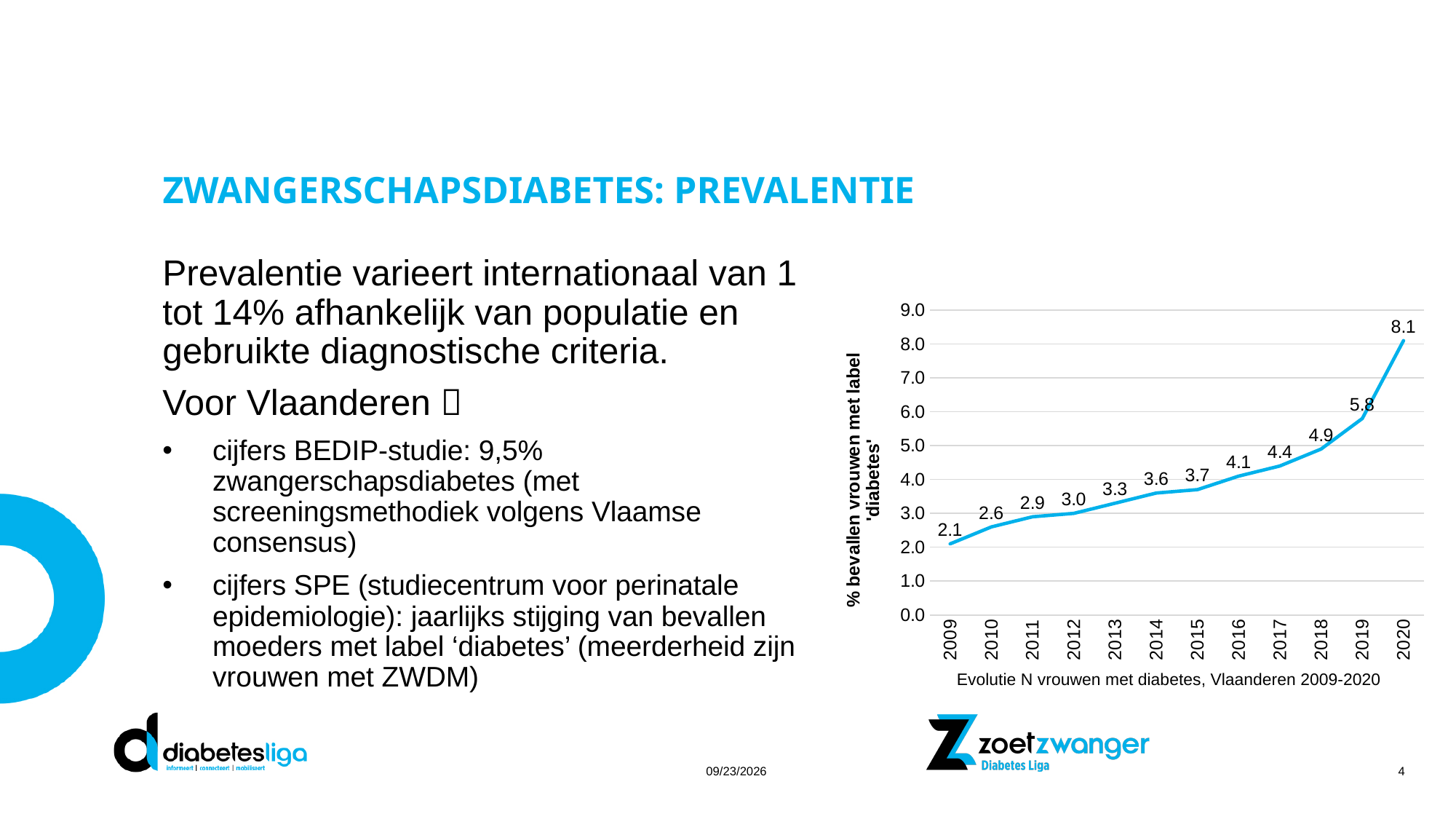
Which is larger, the value for 2017 or the value for 2014? 2017 How many years are plotted on the chart? 12 What is the value for 2015? 3.7 What is the difference between the values for 2020 and 2019? 2.3 What is the label on the y axis of the chart? % bevallen vrouwen met label 'diabetes' Which year has the lowest value? 2009 What kind of chart is shown? line chart Is the value for 2018 greater or less than 4.0? greater What is the value for 2020? 8.1 Which year has the highest value? 2020 Do the values rise or fall from 2009 to 2020? rise What is the value for 2009? 2.1